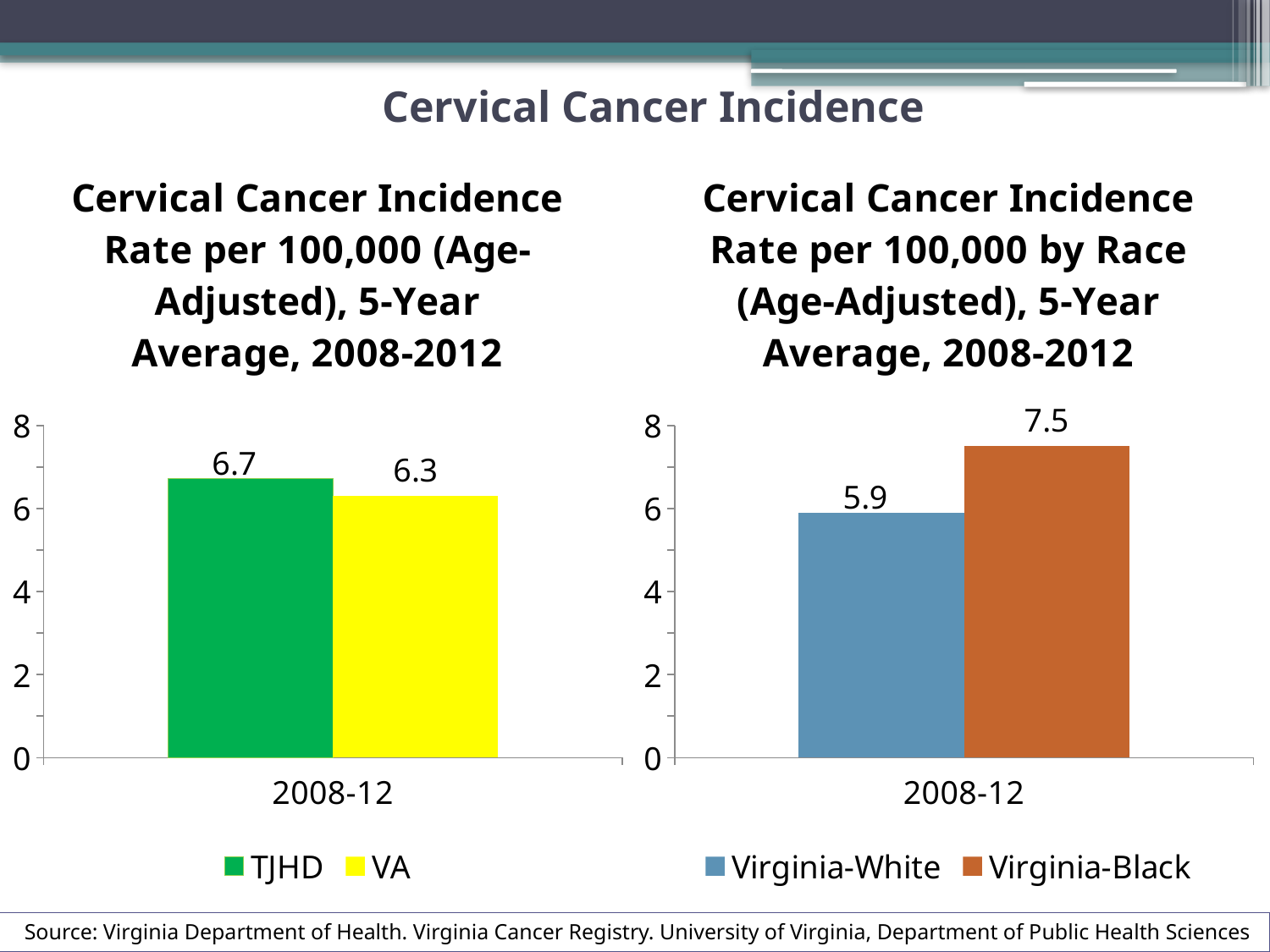
What colour is the bar for Virginia-Black in the right chart? Orange-brown In the right chart, what is the value for Virginia-Black? 7.5 In the right chart, which series has the lowest value? Virginia-White In the right chart, is the value for Virginia-Black greater or less than 6? greater In the left chart, what is the difference between the TJHD and VA values? 0.4 In the right chart, what is the difference between the Virginia-Black and Virginia-White values? 1.6 How many series does the legend of the left chart list? 2 In the left chart, which series has the higher value, TJHD or VA? TJHD What kind of chart is the right chart? Bar chart In the left chart (Cervical Cancer Incidence Rate per 100,000, 5-Year Average, 2008-2012), what is the value for TJHD? 6.7 In the left chart, what is the value for VA? 6.3 In the right chart (Cervical Cancer Incidence Rate per 100,000 by Race), what is the value for Virginia-White? 5.9